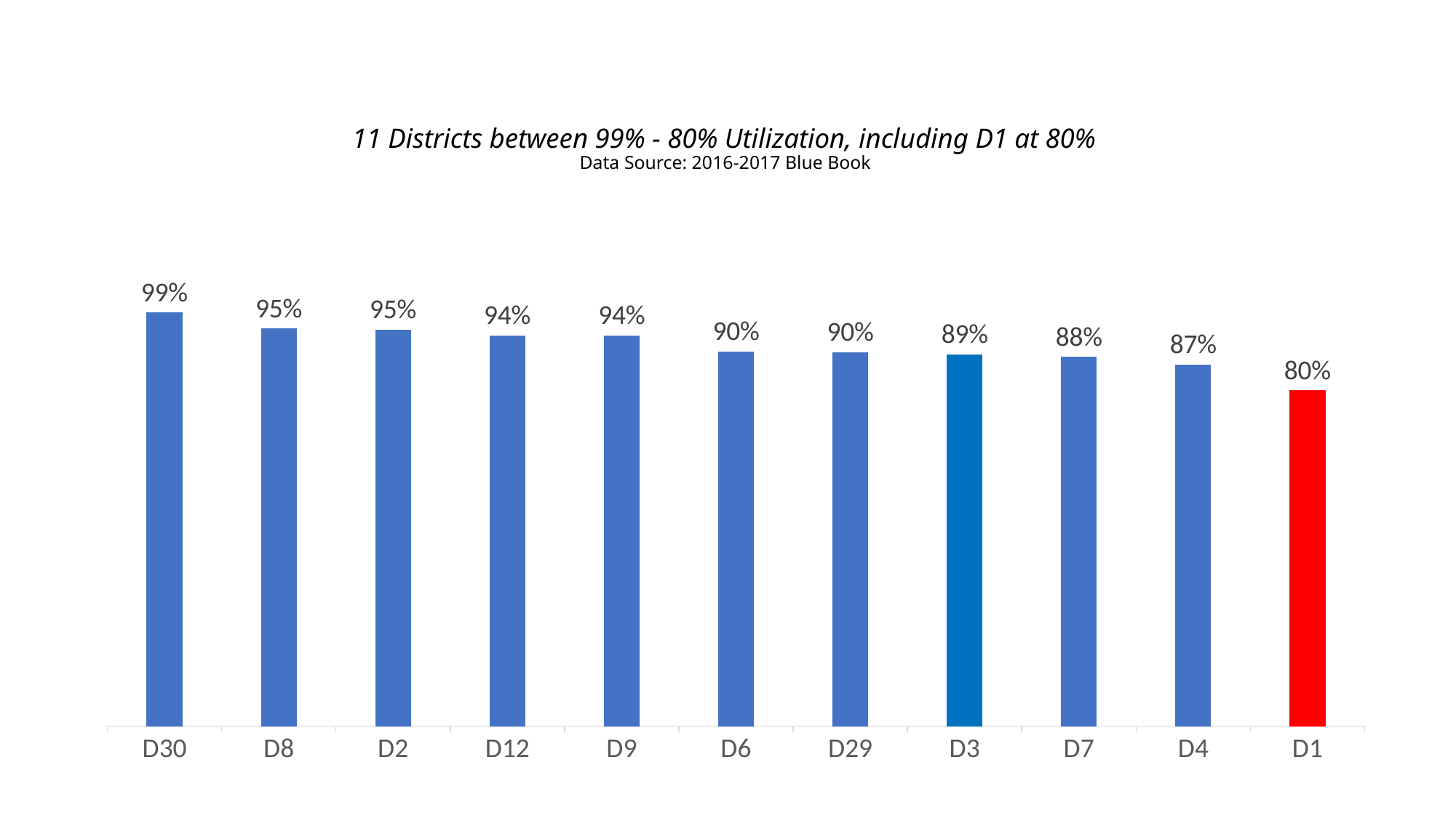
What is the difference in utilization between D30 and D1? 19% What kind of chart is shown on the slide? Bar chart What is the utilization value for D1? 80% How many districts are shown in the chart? 11 Which district has the lowest utilization? D1 Which district has the highest utilization? D30 What is the utilization value for D12? 94% What is the difference in utilization between D8 and D4? 8% Do the utilization values rise or fall from left to right along the x axis? Fall Which district's bar is coloured red? D1 Which has a higher utilization, D6 or D7? D6 What is the utilization value for D3? 89%